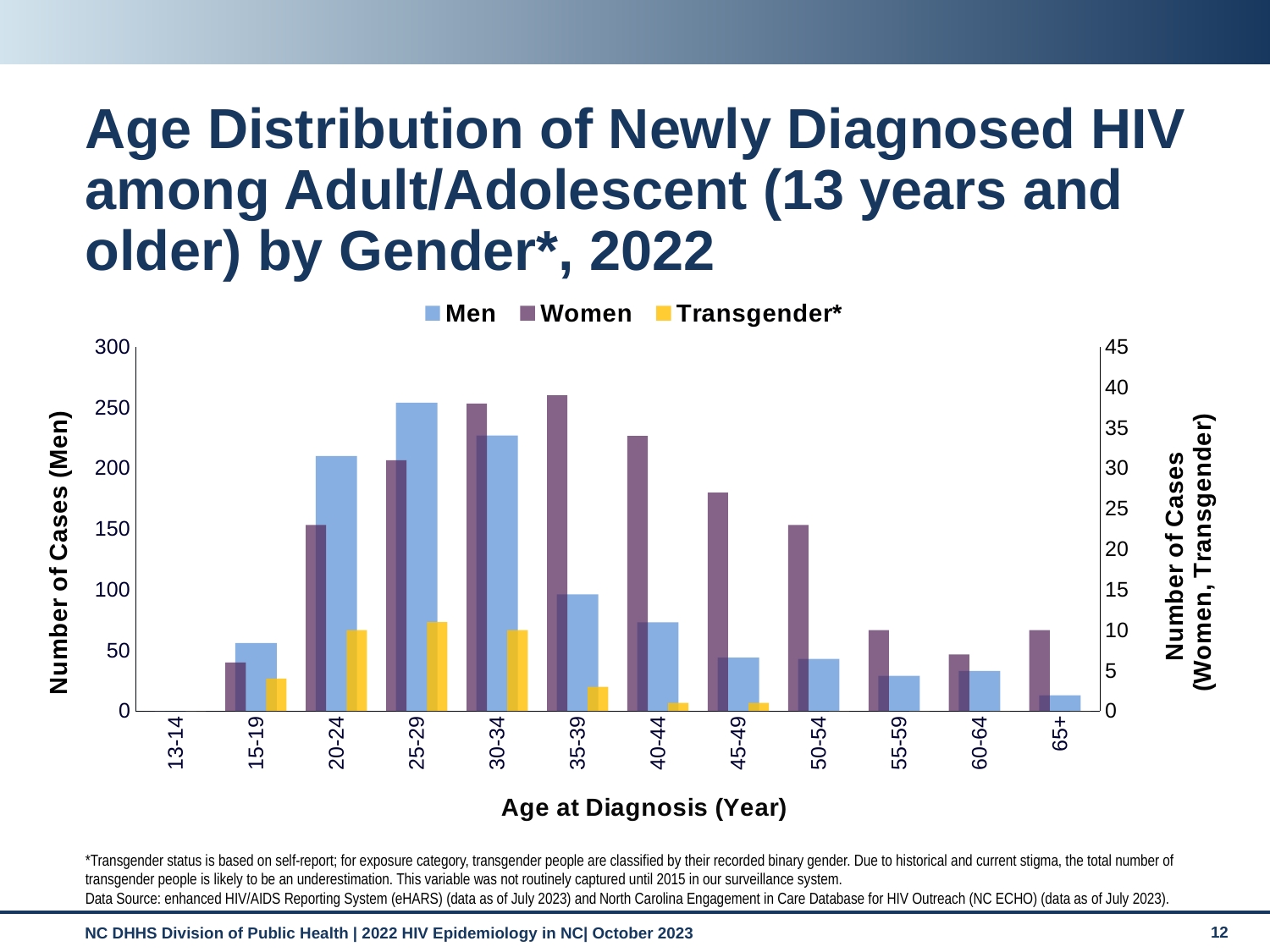
How many series does the legend list? 3 Is the value for Transgender* in the 40-44 age group greater or less than 5 on the right axis? less Which is larger for Men: the 20-24 age group or the 40-44 age group? 20-24 How many age groups are shown on the x axis? 12 Which age group has the highest number of cases for Men? 25-29 What is the title of the left vertical axis? Number of Cases (Men) Which age group has the lowest number of cases for Men? 13-14 Is the value for Women in the 50-54 age group greater or less than 20 on the right axis? greater Is the value for Men in the 40-44 age group greater or less than 100? less Do the values for Men rise or fall across the age groups from 25-29 to 65+? fall What kind of chart is shown on the slide? Bar chart